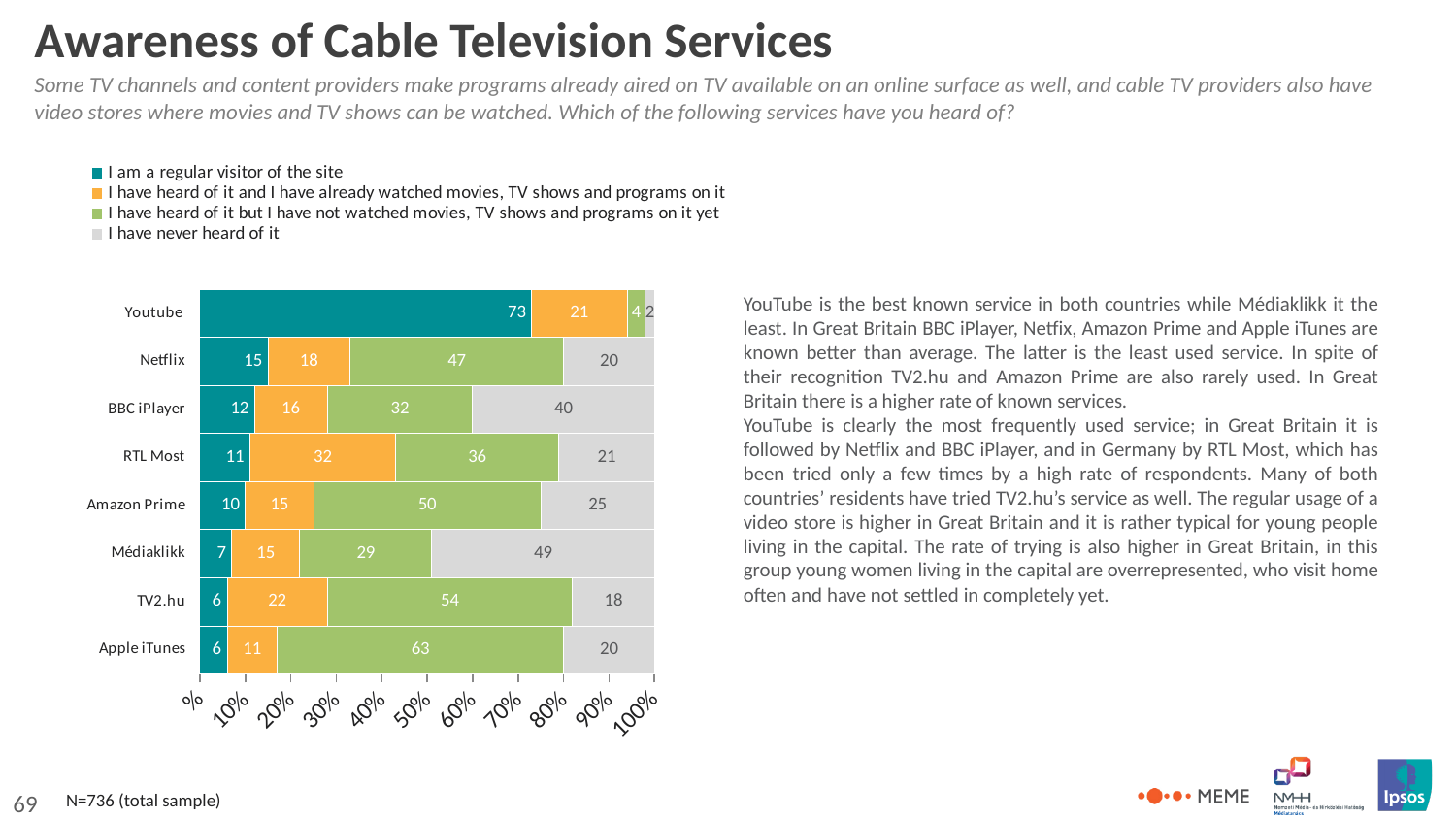
How many series does the legend list? 4 What is the difference between the 'I have never heard of it' values for BBC iPlayer and Netflix? 20 What is the total of the stacked bar for Netflix? 100 Which has a larger 'I have heard of it and I have already watched movies, TV shows and programs on it' value, RTL Most or TV2.hu? RTL Most What is the value for 'I have heard of it but I have not watched movies, TV shows and programs on it yet' for Apple iTunes? 63 Which colour represents 'I am a regular visitor of the site' in the chart? Teal (dark blue-green) Which service has the highest share of regular visitors? Youtube What kind of chart is shown on the slide? Stacked bar chart What is the value for 'I have never heard of it' for Médiaklikk? 49 Which service has the lowest share of respondents who have never heard of it? Youtube How many services (categories) are shown in the chart? 8 What percentage of respondents are regular visitors of Youtube? 73